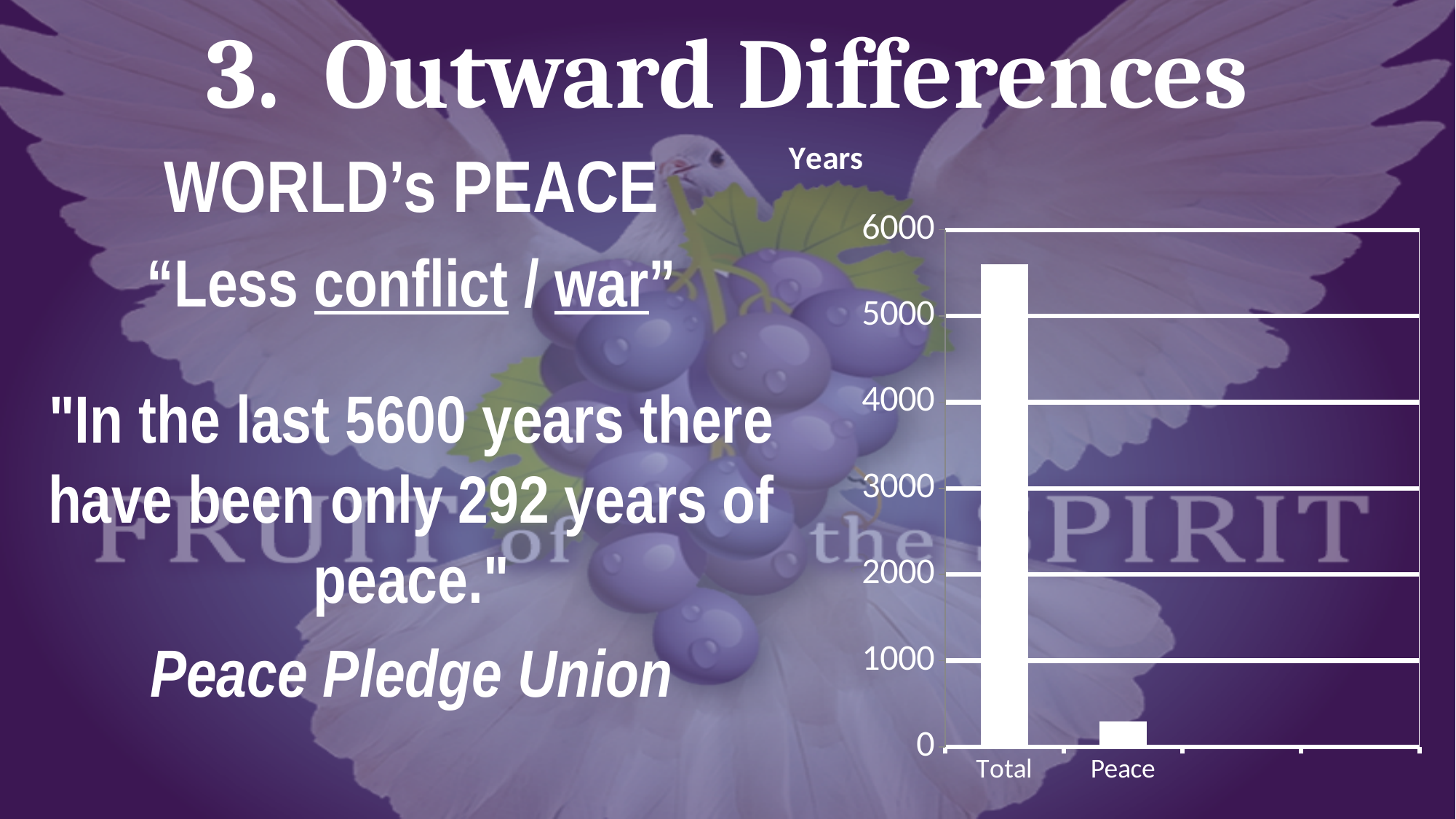
What is the label shown above the vertical axis of the chart? Years Is the value for Peace greater or less than 1000? less Which bar is taller, Total or Peace? Total Is the value for Total greater or less than 5000? greater Is the value for Peace greater or less than 2000? less What kind of chart is shown on the slide? bar chart Which category has the lowest bar on the chart? Peace Which category has the highest bar on the chart? Total How many categories are plotted on the chart? 2 What is the highest tick value shown on the vertical axis of the chart? 6000